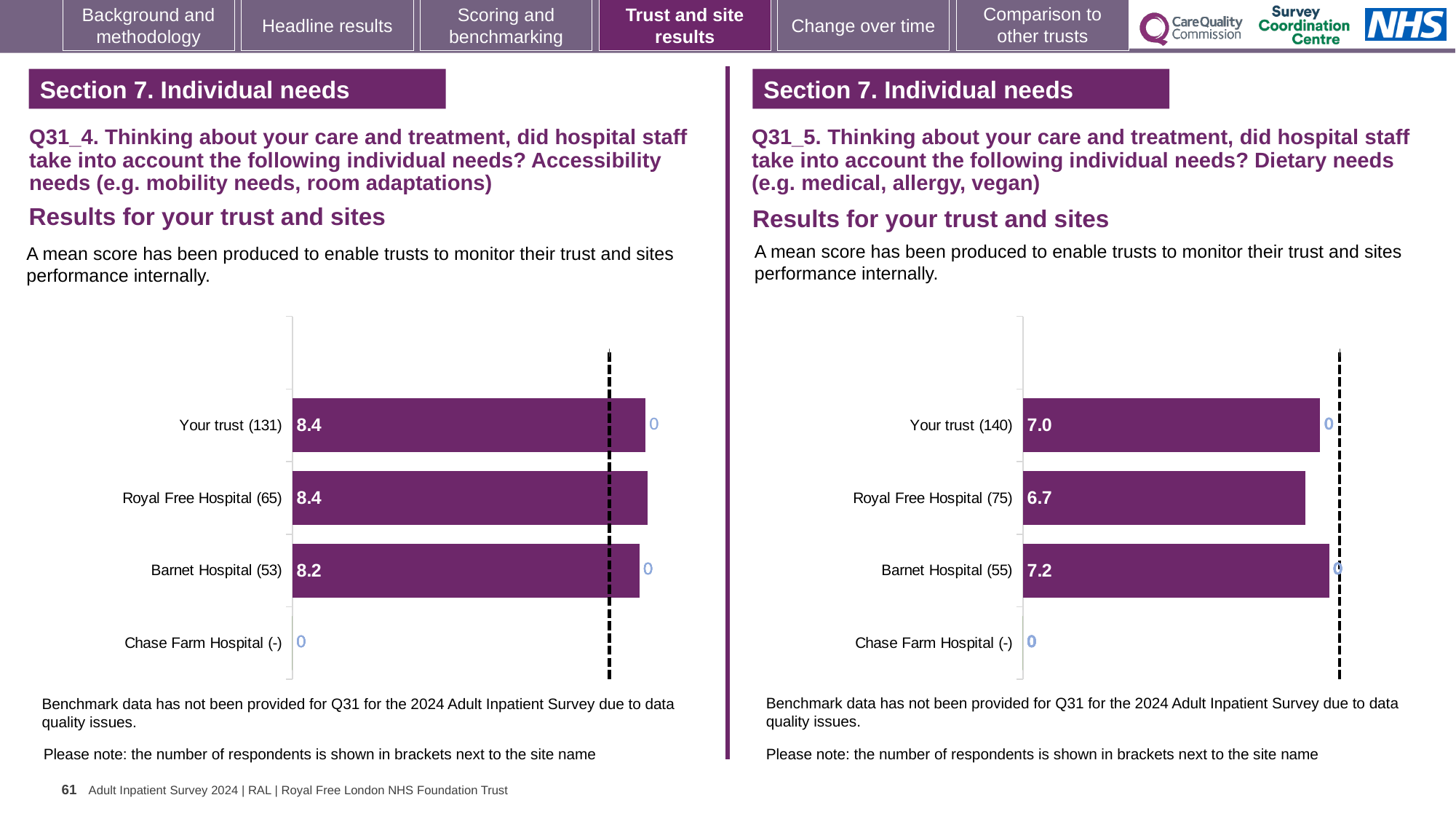
What kind of chart is used on the left side of the slide for Q31_4? Bar chart In the right chart (Q31_5, dietary needs), what is the mean score for Royal Free Hospital? 6.7 In the left chart (Q31_4, accessibility needs), which site has the lowest mean score among those with a plotted value? Barnet Hospital In the left chart (Q31_4, accessibility needs), how many respondents are shown in brackets for Royal Free Hospital? 65 In the right chart (Q31_5, dietary needs), what is the mean score for Your trust? 7.0 In the right chart (Q31_5, dietary needs), which site has the highest mean score? Barnet Hospital In the right chart (Q31_5, dietary needs), which is larger: the mean score for Your trust or for Royal Free Hospital? Your trust In the left chart (Q31_4, accessibility needs), what is the mean score for Your trust? 8.4 In the left chart (Q31_4, accessibility needs), what is the mean score for Barnet Hospital? 8.2 In the left chart (Q31_4, accessibility needs), what is the difference between the mean scores for Your trust and Barnet Hospital? 0.2 In the right chart (Q31_5, dietary needs), what is the difference between the mean scores for Barnet Hospital and Royal Free Hospital? 0.5 In the right chart (Q31_5, dietary needs), which site has the lowest mean score among those with a plotted value? Royal Free Hospital